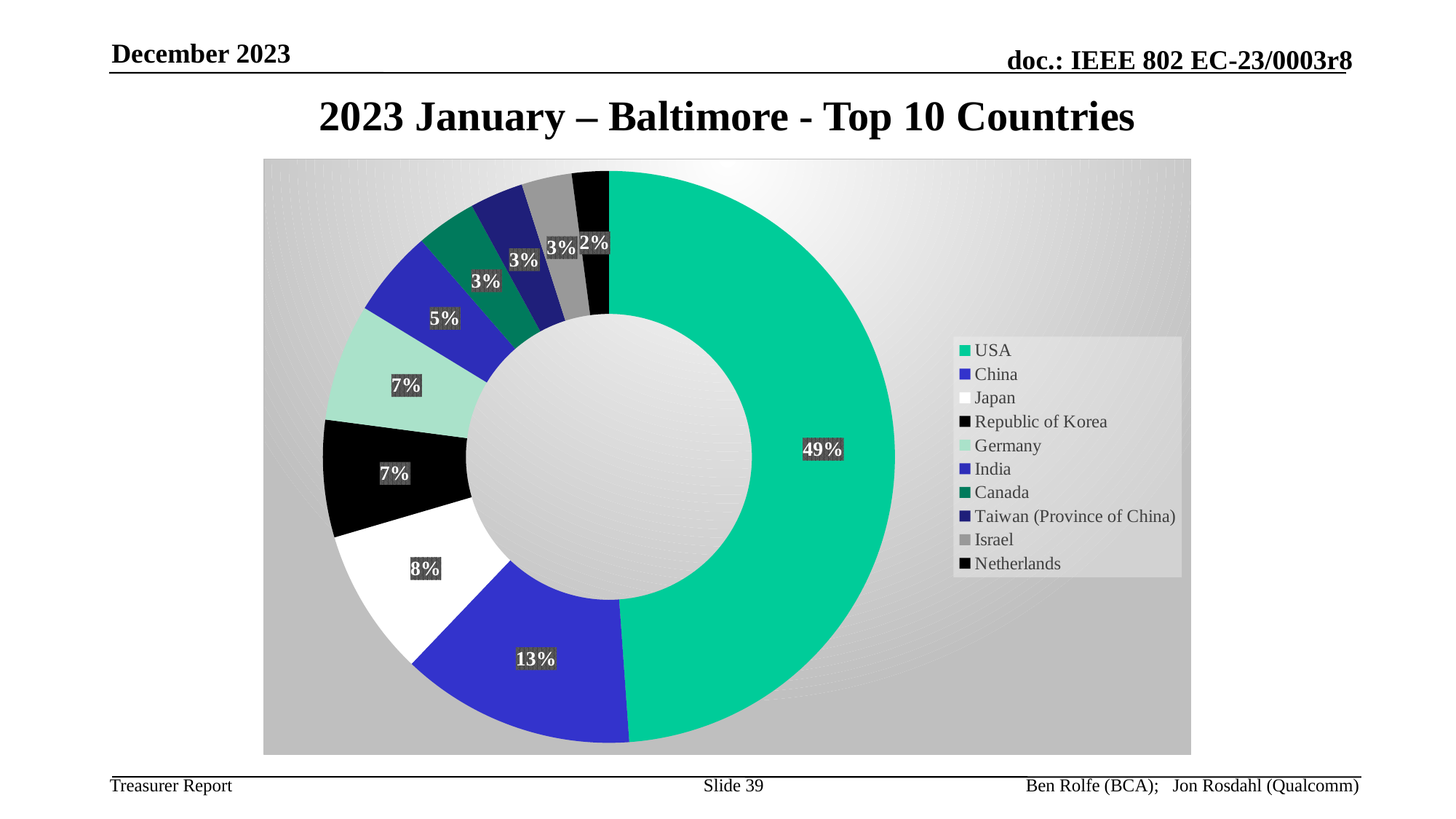
What percentage is shown for India? 5% What share of the chart does USA account for? 49% What percentage is shown for China? 13% What is the difference in percentage points between USA and China? 36 Which country has the smallest share of the chart? Netherlands What type of chart is shown on the slide? Doughnut (pie) chart Which country has the largest share of the chart? USA Which has a larger share, Japan or India? Japan What is the title of the chart on the slide? 2023 January – Baltimore - Top 10 Countries How many countries are listed in the legend? 10 What percentage is shown for Netherlands? 2% What percentage is shown for Japan? 8%